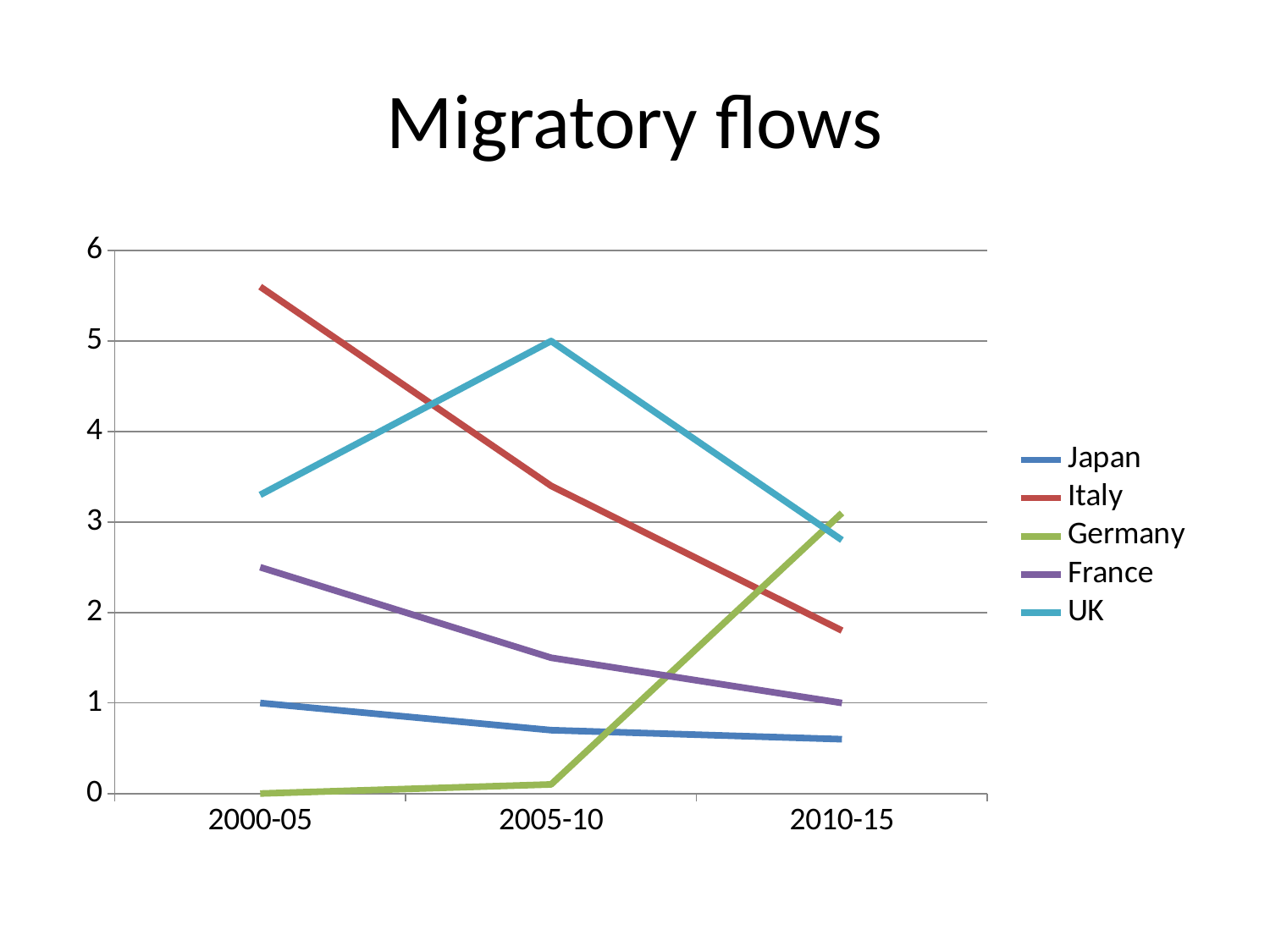
What is the value for Japan in 2000-05? 1 How many series does the legend list? 5 What is the value for France in 2010-15? 1 What is the value for UK in 2005-10? 5 In 2005-10, which is larger, the value for UK or the value for Italy? UK How many periods are shown on the x axis? 3 What is the title of the chart? Migratory flows Is the value for Italy in 2000-05 greater or less than 5? greater Does the Italy series rise or fall from 2000-05 to 2010-15? fall Which series has the highest value in 2000-05? Italy What kind of chart is shown on the slide? line chart Which series has the lowest value in 2010-15? Japan